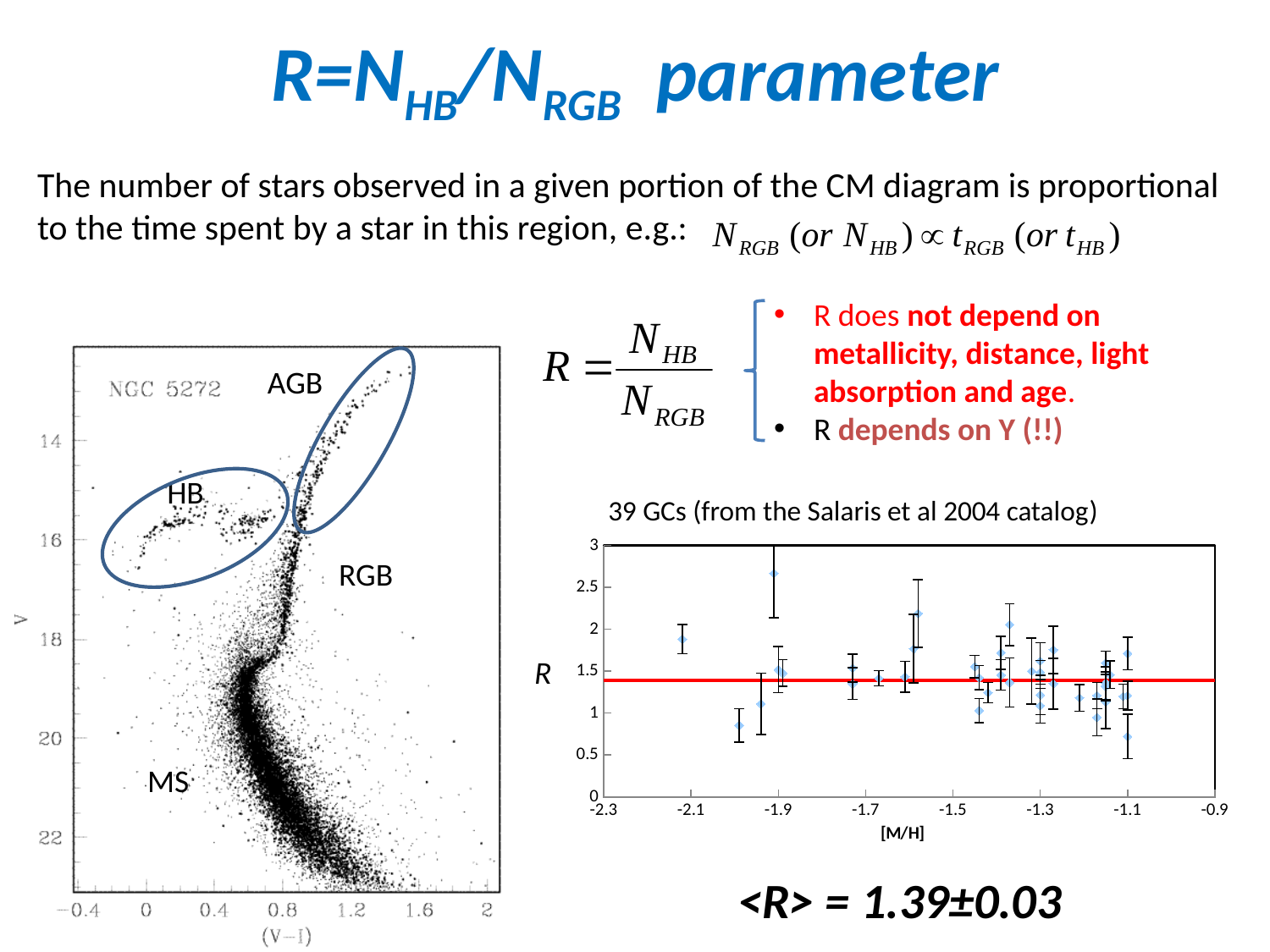
On the right-hand chart, is the highest R value (near [M/H] = -1.9) greater or less than 2.5? greater On the right-hand chart, is the R value of the leftmost point (near [M/H] = -2.1) greater or less than 1.5? greater On the right-hand chart, is the lowest R value (near [M/H] = -1.1) greater or less than 1? less What kind of chart is the right-hand chart of R versus [M/H]? scatter plot with error bars How many stellar evolutionary regions are labelled on the left-hand colour-magnitude diagram? 4 According to the title of the right-hand chart, how many globular clusters are plotted? 39 On the right-hand chart, what is the label of the y axis? R On the left-hand colour-magnitude diagram, what quantity is plotted on the x axis? (V-I) What mean value of R is stated below the right-hand chart? <R> = 1.39±0.03 Which globular cluster is shown in the left-hand colour-magnitude diagram? NGC 5272